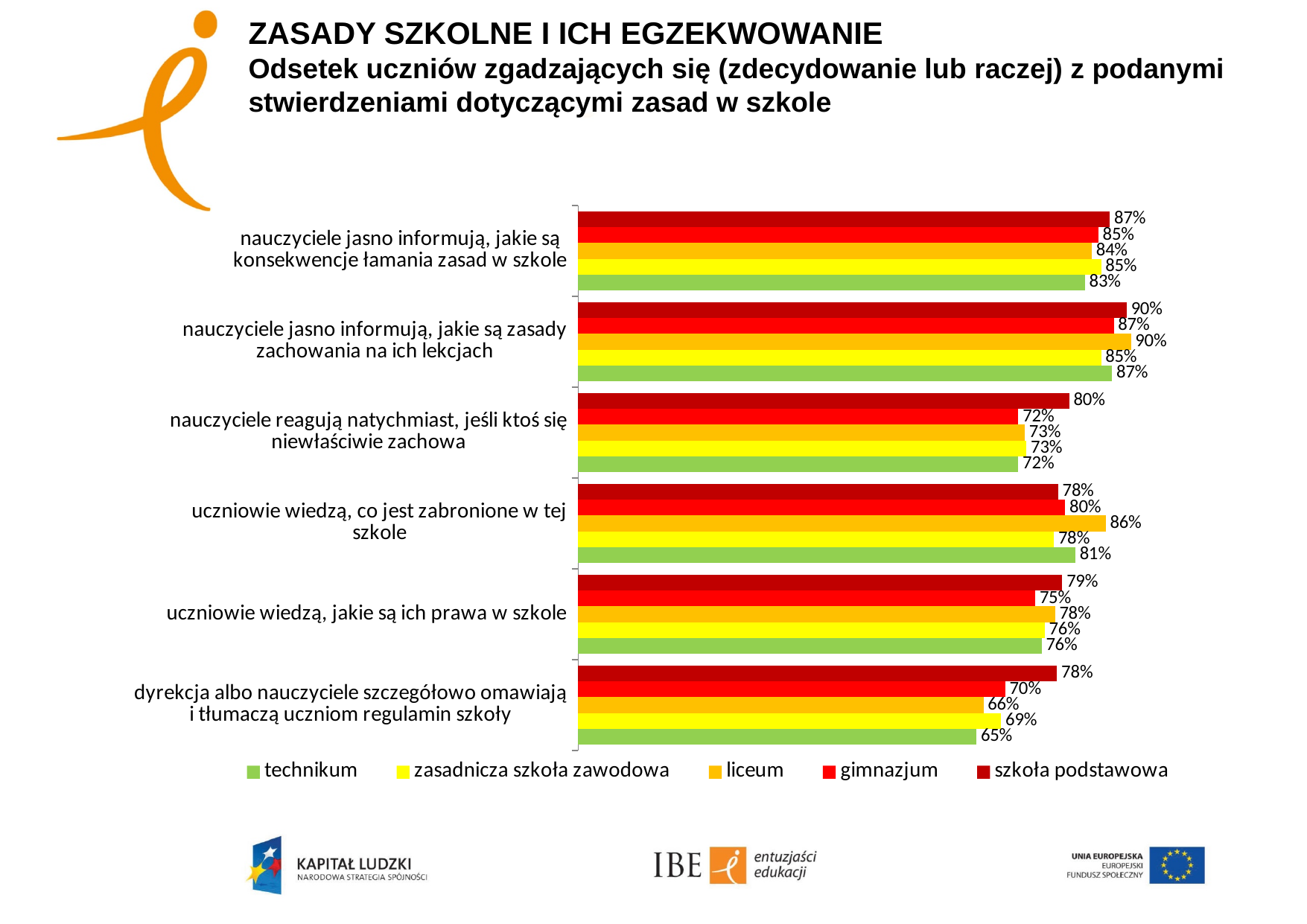
What kind of chart is shown on the slide? bar chart How many statements (categories) are shown on the chart? 6 What is the difference between the szkoła podstawowa and gimnazjum values for the statement 'dyrekcja albo nauczyciele szczegółowo omawiają i tłumaczą uczniom regulamin szkoły'? 8% What is the value for liceum for the statement 'uczniowie wiedzą, co jest zabronione w tej szkole'? 86% Which school type has the lowest value for the statement 'dyrekcja albo nauczyciele szczegółowo omawiają i tłumaczą uczniom regulamin szkoły'? technikum Which colour represents liceum in the legend? orange For the statement 'uczniowie wiedzą, jakie są ich prawa w szkole', which is larger: the value for szkoła podstawowa or for gimnazjum? szkoła podstawowa What is the value for szkoła podstawowa for the statement 'nauczyciele jasno informują, jakie są zasady zachowania na ich lekcjach'? 90% What is the difference between the szkoła podstawowa and technikum values for the statement 'nauczyciele reagują natychmiast, jeśli ktoś się niewłaściwie zachowa'? 8% How many series does the legend list? 5 Which school type has the highest value for the statement 'nauczyciele reagują natychmiast, jeśli ktoś się niewłaściwie zachowa'? szkoła podstawowa What is the value for technikum for the statement 'dyrekcja albo nauczyciele szczegółowo omawiają i tłumaczą uczniom regulamin szkoły'? 65%